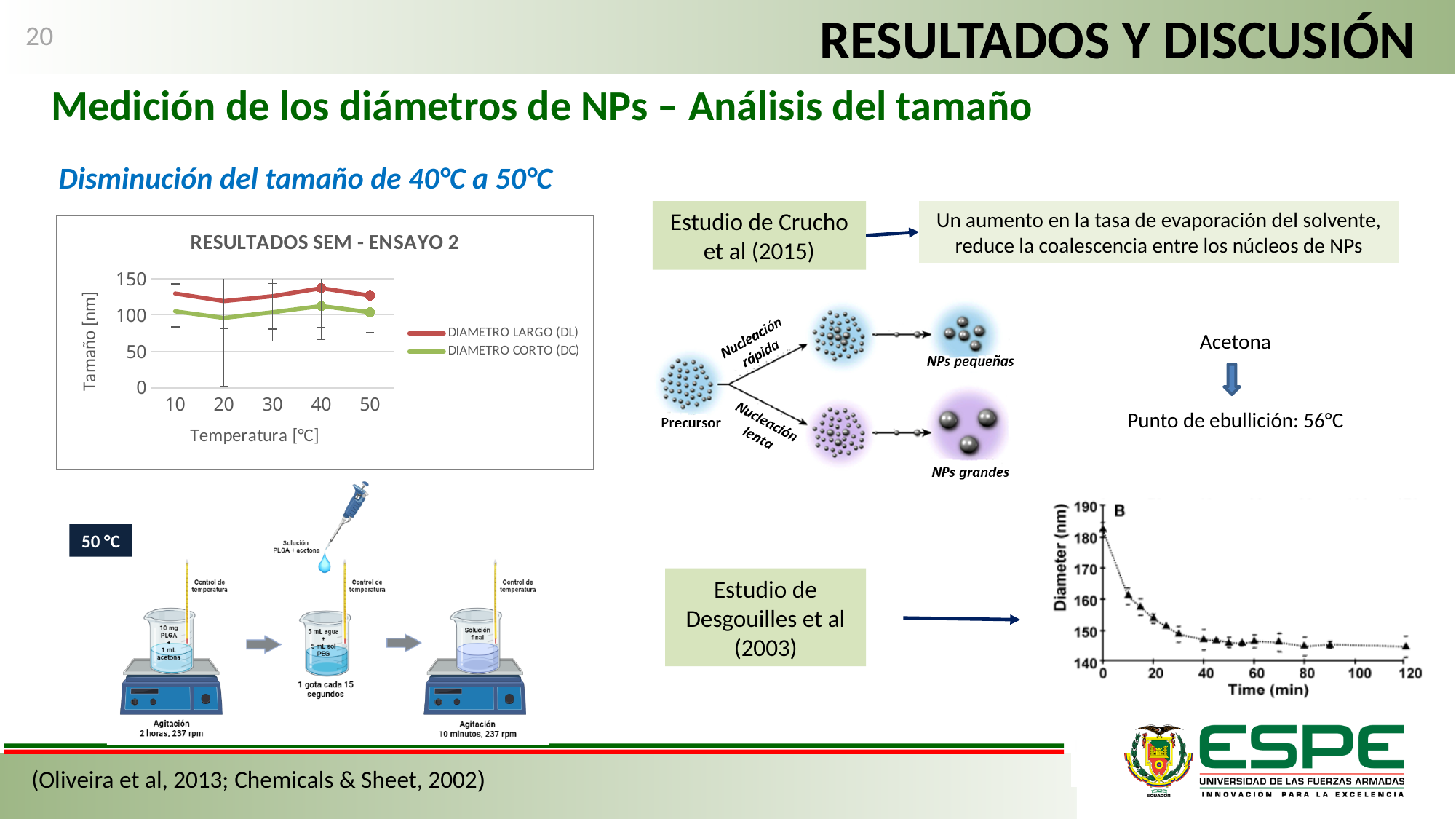
In the chart titled 'RESULTADOS SEM - ENSAYO 2', what is the label of the y axis? Tamaño [nm] In the chart titled 'RESULTADOS SEM - ENSAYO 2', which series is drawn in red? DIAMETRO LARGO (DL) In the chart titled 'RESULTADOS SEM - ENSAYO 2', does the DIAMETRO LARGO (DL) series rise or fall from 40 °C to 50 °C? fall In the chart titled 'RESULTADOS SEM - ENSAYO 2', is the DIAMETRO LARGO (DL) value at 40 °C greater or less than 100? greater In the chart titled 'RESULTADOS SEM - ENSAYO 2', is the DIAMETRO CORTO (DC) value at 50 °C greater or less than 150? less In the chart titled 'RESULTADOS SEM - ENSAYO 2', at 40 °C, which series has the larger value, DIAMETRO LARGO (DL) or DIAMETRO CORTO (DC)? DIAMETRO LARGO (DL) In the chart titled 'RESULTADOS SEM - ENSAYO 2', at which temperature does DIAMETRO LARGO (DL) reach its highest value? 40 In the chart titled 'RESULTADOS SEM - ENSAYO 2', how many series does the legend list? 2 In the chart titled 'RESULTADOS SEM - ENSAYO 2', what kind of chart is shown? line chart In the Diameter vs Time chart at the bottom right, does the diameter rise or fall as time increases from 0 to 40 min? fall In the chart titled 'RESULTADOS SEM - ENSAYO 2', how many temperature points are plotted along the x axis? 5 In the Diameter vs Time chart at the bottom right, is the diameter at 0 min greater or less than 170? greater